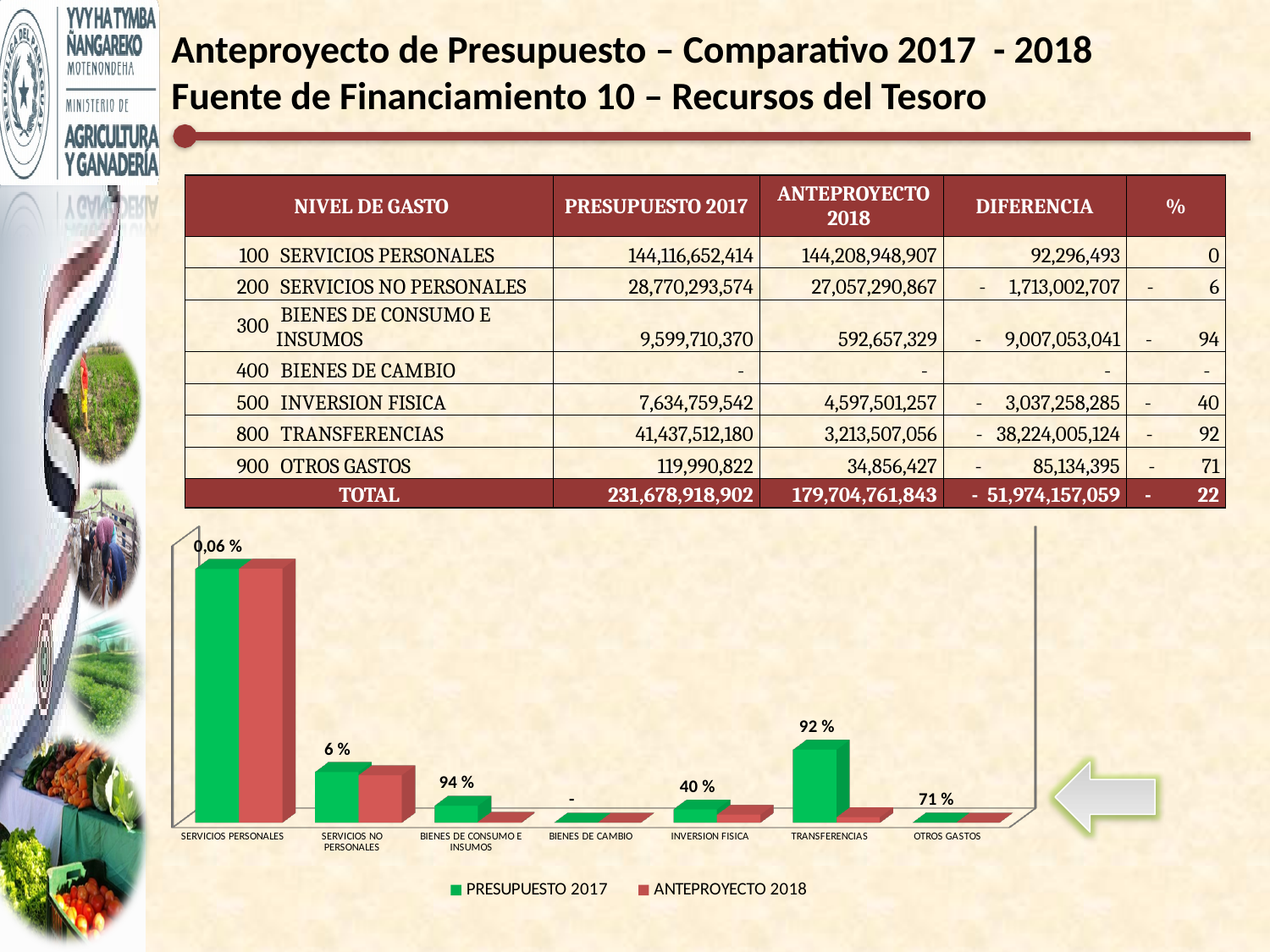
Which category shows no visible bars in the chart? BIENES DE CAMBIO What kind of chart is shown on the slide? bar chart Which colour represents the ANTEPROYECTO 2018 series in the chart? red What percentage label is printed above the OTROS GASTOS bars in the chart? 71 % In the chart, which is larger for INVERSION FISICA: PRESUPUESTO 2017 or ANTEPROYECTO 2018? PRESUPUESTO 2017 How many series does the chart legend list? 2 What percentage label is printed above the TRANSFERENCIAS bars in the chart? 92 % What percentage label is printed above the INVERSION FISICA bars in the chart? 40 % How many categories are shown along the x axis of the chart? 7 In the chart, which is larger for BIENES DE CONSUMO E INSUMOS: PRESUPUESTO 2017 or ANTEPROYECTO 2018? PRESUPUESTO 2017 Which category has the tallest bars in the chart? SERVICIOS PERSONALES In the chart, which is larger for TRANSFERENCIAS: PRESUPUESTO 2017 or ANTEPROYECTO 2018? PRESUPUESTO 2017